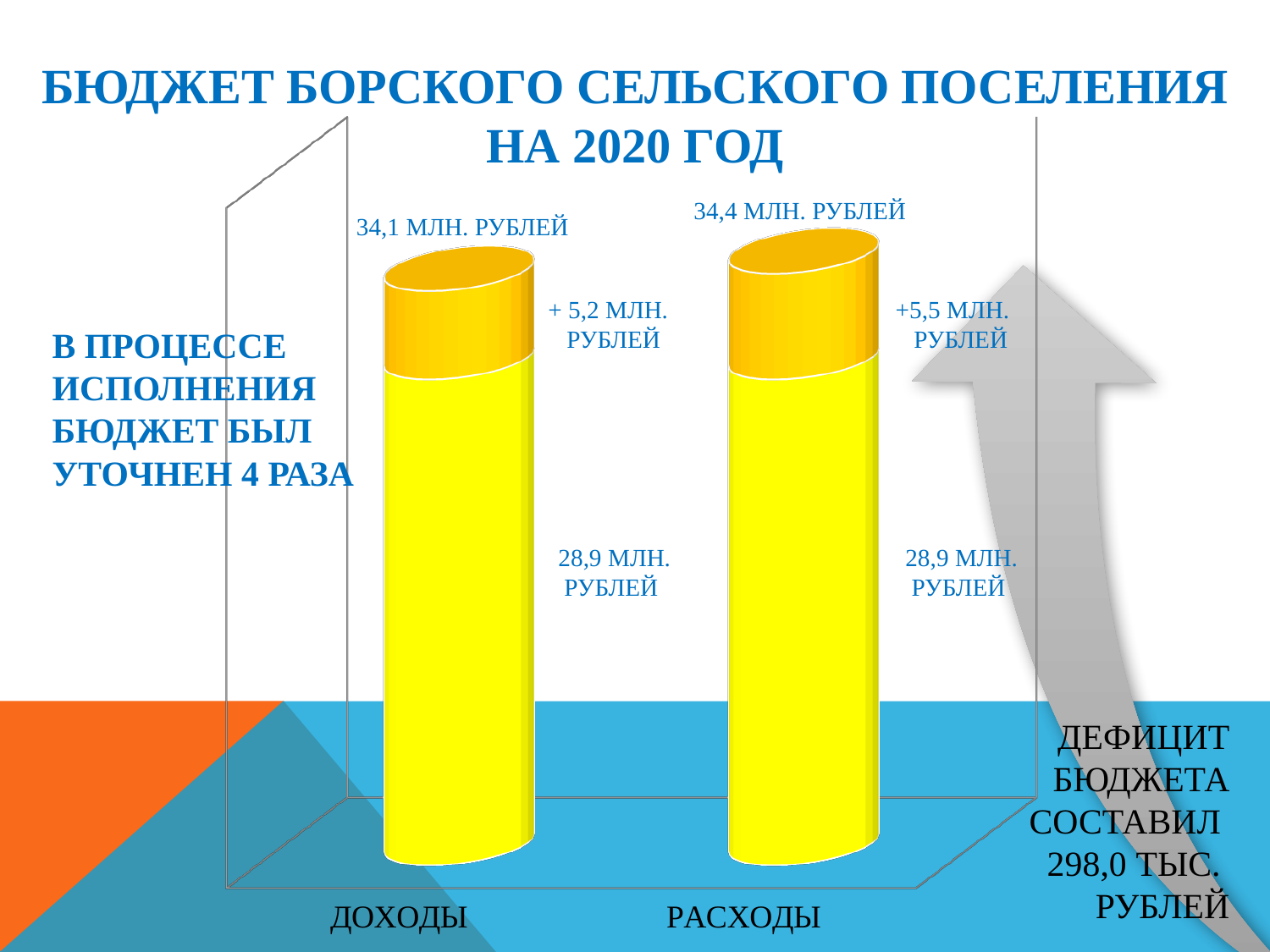
What is the title of the slide? БЮДЖЕТ БОРСКОГО СЕЛЬСКОГО ПОСЕЛЕНИЯ НА 2020 ГОД What is the value of the lower (base) segment of the ДОХОДЫ bar? 28,9 млн. рублей What kind of chart is shown on the slide? Bar chart What is the value of the upper (added) segment of the ДОХОДЫ bar? + 5,2 млн. рублей What colour are the bars on the chart? Yellow What is the difference between the added segment of РАСХОДЫ and the added segment of ДОХОДЫ? 0,3 млн. рублей How many categories are shown on the chart? 2 Which category has the higher total, ДОХОДЫ or РАСХОДЫ? РАСХОДЫ What is the difference between the total for РАСХОДЫ and the total for ДОХОДЫ? 0,3 млн. рублей What is the total value shown for ДОХОДЫ? 34,1 млн. рублей What is the value of the upper (added) segment of the РАСХОДЫ bar? +5,5 млн. рублей What is the total value shown for РАСХОДЫ? 34,4 млн. рублей